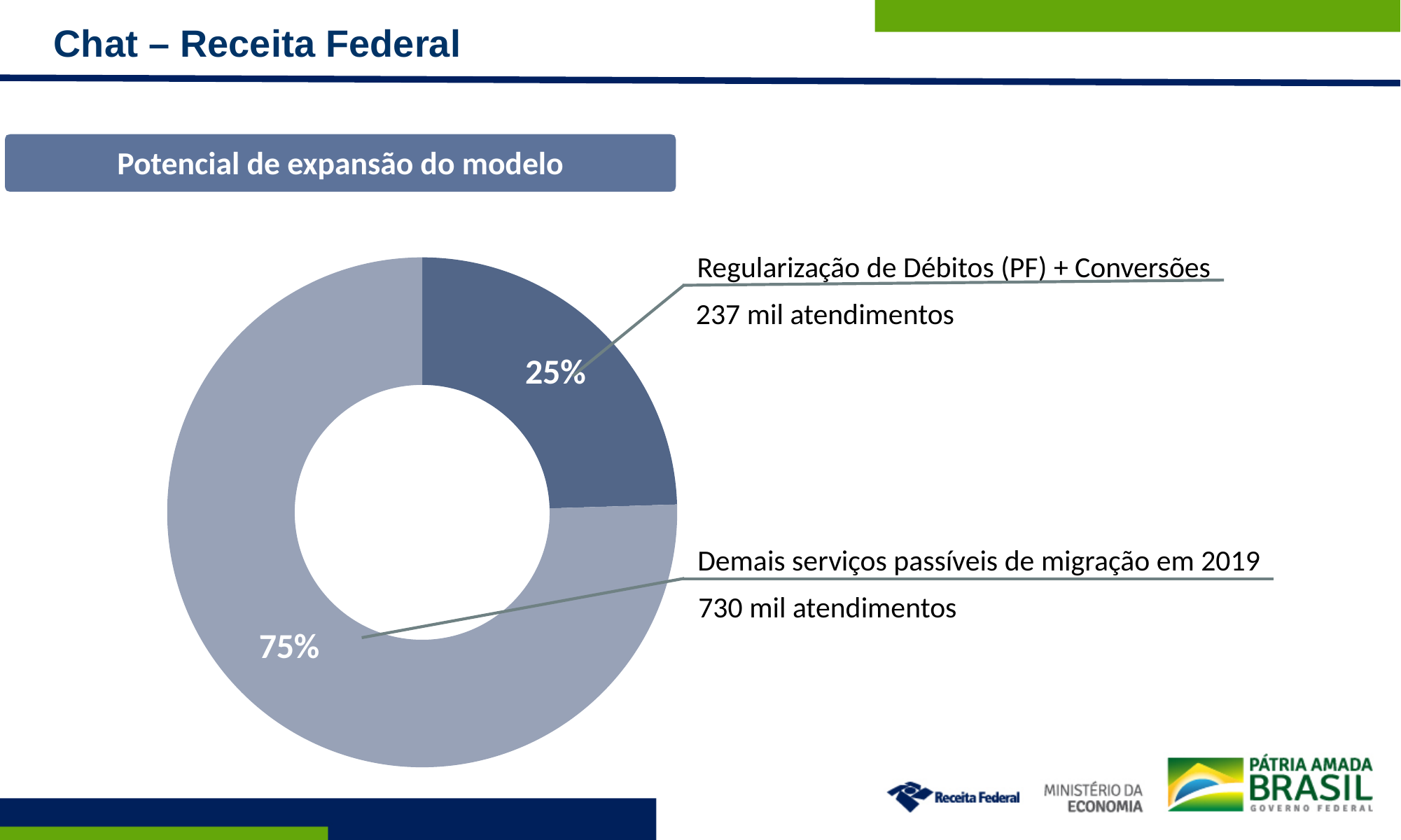
How many slices does the chart have? 2 Which slice of the chart is the largest? Demais serviços passíveis de migração em 2019 What kind of chart is shown on the slide? Donut (pie) chart What is the difference in atendimentos between the two slices (730 mil minus 237 mil)? 493 mil atendimentos What is the title shown in the box above the chart? Potencial de expansão do modelo Which slice of the chart is the smallest? Regularização de Débitos (PF) + Conversões How many atendimentos are shown for "Regularização de Débitos (PF) + Conversões"? 237 mil atendimentos How many atendimentos are shown for "Demais serviços passíveis de migração em 2019"? 730 mil atendimentos What is the difference in percentage points between the 75% slice and the 25% slice? 50 percentage points What share of the chart does "Demais serviços passíveis de migração em 2019" represent? 75% Which has more atendimentos: "Regularização de Débitos (PF) + Conversões" or "Demais serviços passíveis de migração em 2019"? Demais serviços passíveis de migração em 2019 What share of the chart does "Regularização de Débitos (PF) + Conversões" represent? 25%